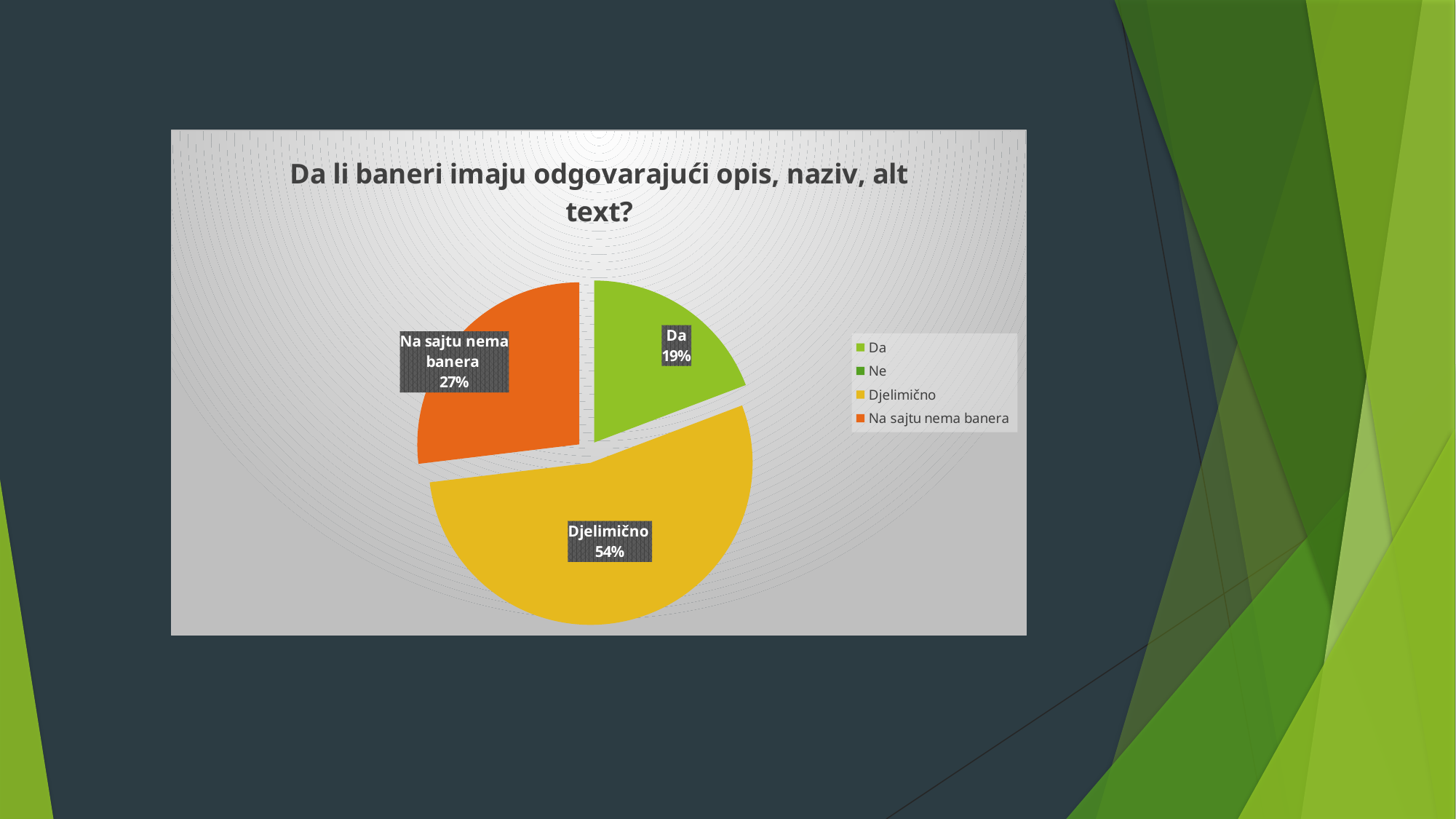
Which is larger, the share for "Da" or the share for "Na sajtu nema banera"? Na sajtu nema banera What kind of chart is shown on the slide? pie chart What is the title of the chart? Da li baneri imaju odgovarajući opis, naziv, alt text? How many entries does the legend list? 4 What colour is the "Djelimično" slice? yellow What percentage of the pie is labelled "Na sajtu nema banera"? 27% Which category has the largest share of the pie? Djelimično What is the difference in percentage points between "Na sajtu nema banera" and "Da"? 8 What is the difference in percentage points between "Djelimično" and "Na sajtu nema banera"? 27 Which labelled slice has the smallest share of the pie? Da What percentage of the pie is labelled "Da"? 19% What percentage of the pie is labelled "Djelimično"? 54%